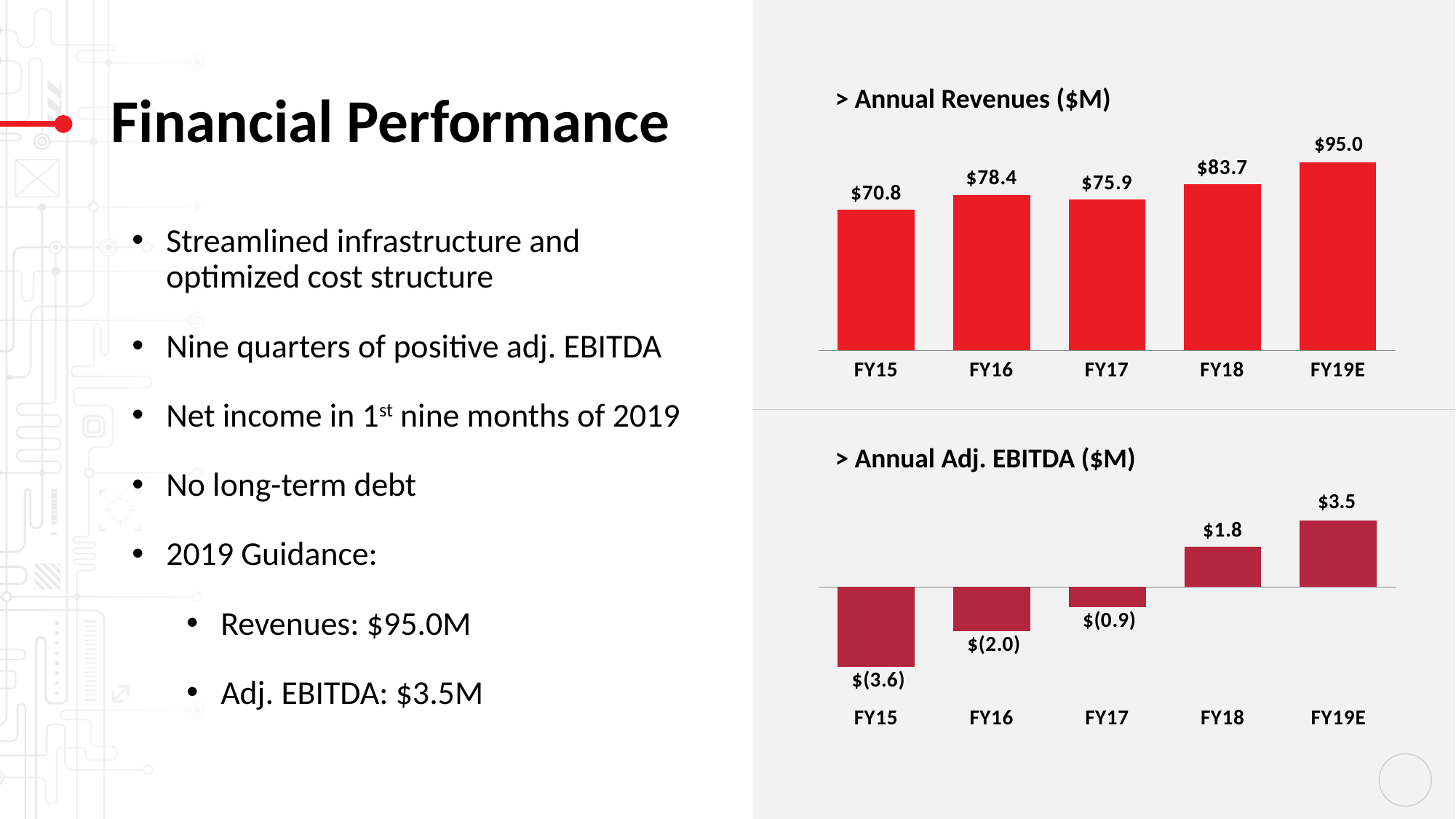
In the Annual Adj. EBITDA ($M) chart, what is the value for FY18? $1.8 What kind of chart is the Annual Adj. EBITDA ($M) chart? bar chart In the Annual Revenues ($M) chart, which is larger, FY16 or FY17? FY16 In the Annual Revenues ($M) chart, how many years are shown? 5 In the Annual Adj. EBITDA ($M) chart, how many years show a negative value? 3 In the Annual Adj. EBITDA ($M) chart, do the values rise or fall from FY15 to FY19E? rise In the Annual Revenues ($M) chart, what is the value for FY17? $75.9 In the Annual Adj. EBITDA ($M) chart, what is the value for FY16? $(2.0) In the Annual Revenues ($M) chart, what is the difference between FY19E and FY18 revenues? $11.3 In the Annual Revenues ($M) chart, which year has the highest revenue? FY19E In the Annual Revenues ($M) chart, which year has the lowest revenue? FY15 In the Annual Adj. EBITDA ($M) chart, which year has the lowest value? FY15